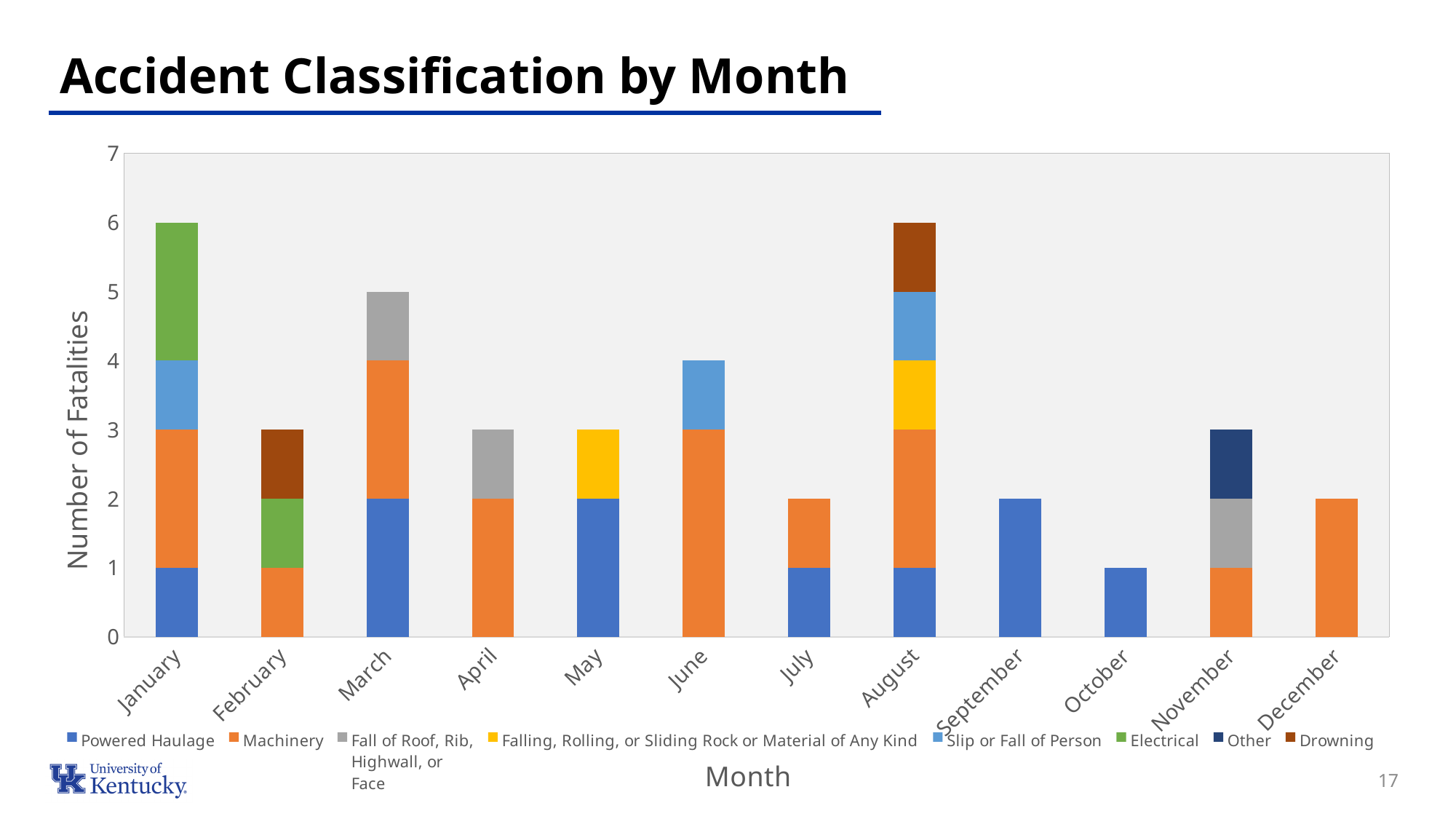
What is the total number of fatalities in March? 5 What is the difference between the total fatalities in January and in February? 3 Which month has the lowest total number of fatalities? October What is the label of the y axis? Number of Fatalities How many Powered Haulage fatalities occurred in May? 2 What kind of chart is shown on the slide? Stacked bar chart How many months are shown on the x axis? 12 How many series does the legend list? 8 Which month has more total fatalities, June or July? June Is the total number of fatalities in June greater or less than 3? greater What is the total number of fatalities in August? 6 How many Electrical fatalities occurred in January? 2